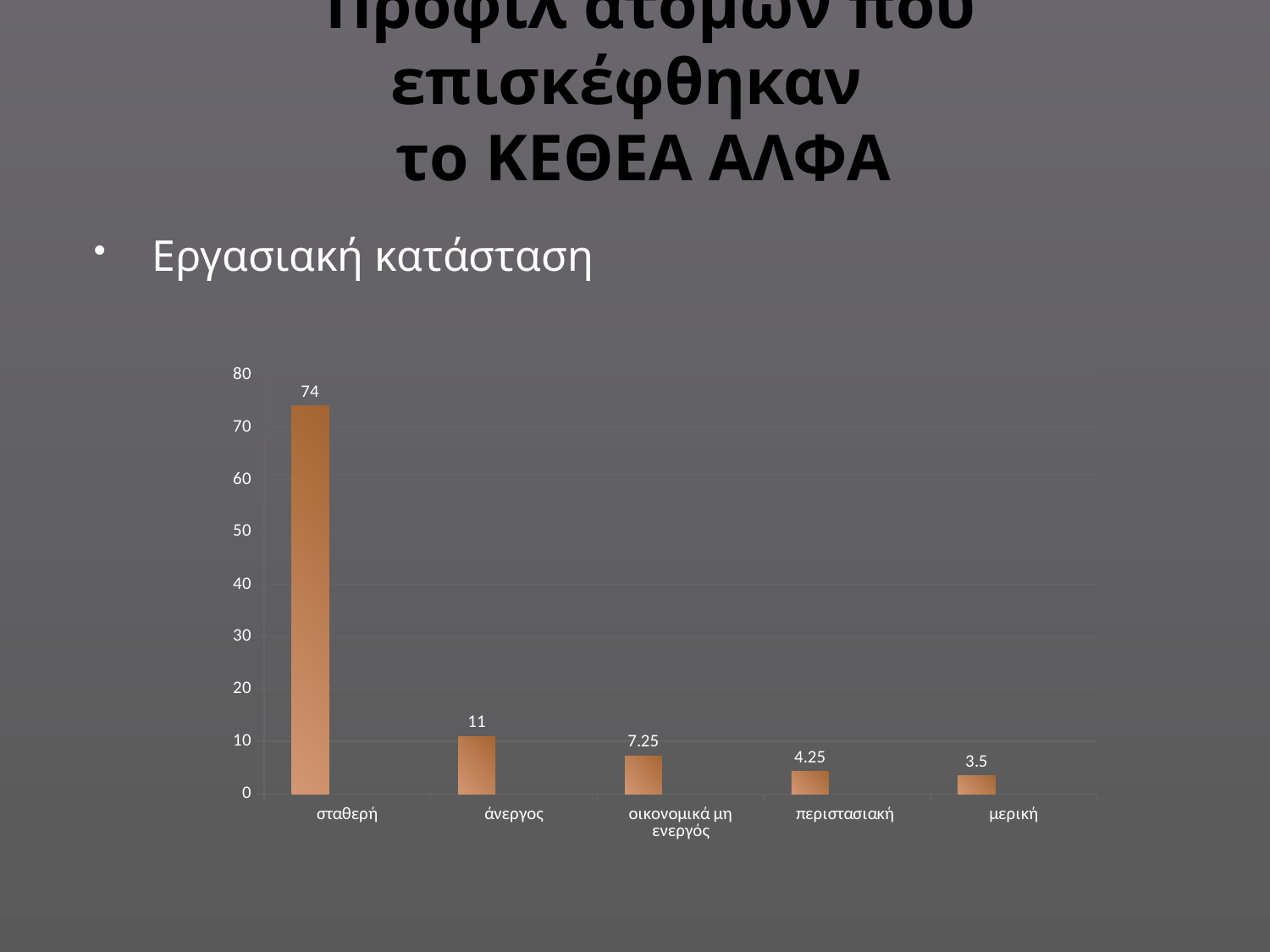
Which category has the highest value? σταθερή Which category has the lowest value? μερική What is the value for μερική? 3.5 What is the value for σταθερή? 74 What kind of chart is shown on the slide? bar chart Do the values rise or fall from left to right along the x axis? fall What is the value for άνεργος? 11 Which is larger, the value for περιστασιακή or the value for μερική? περιστασιακή What is the value for οικονομικά μη ενεργός? 7.25 What is the value for περιστασιακή? 4.25 What is the difference between the values for σταθερή and άνεργος? 63 How many categories are shown on the x axis? 5